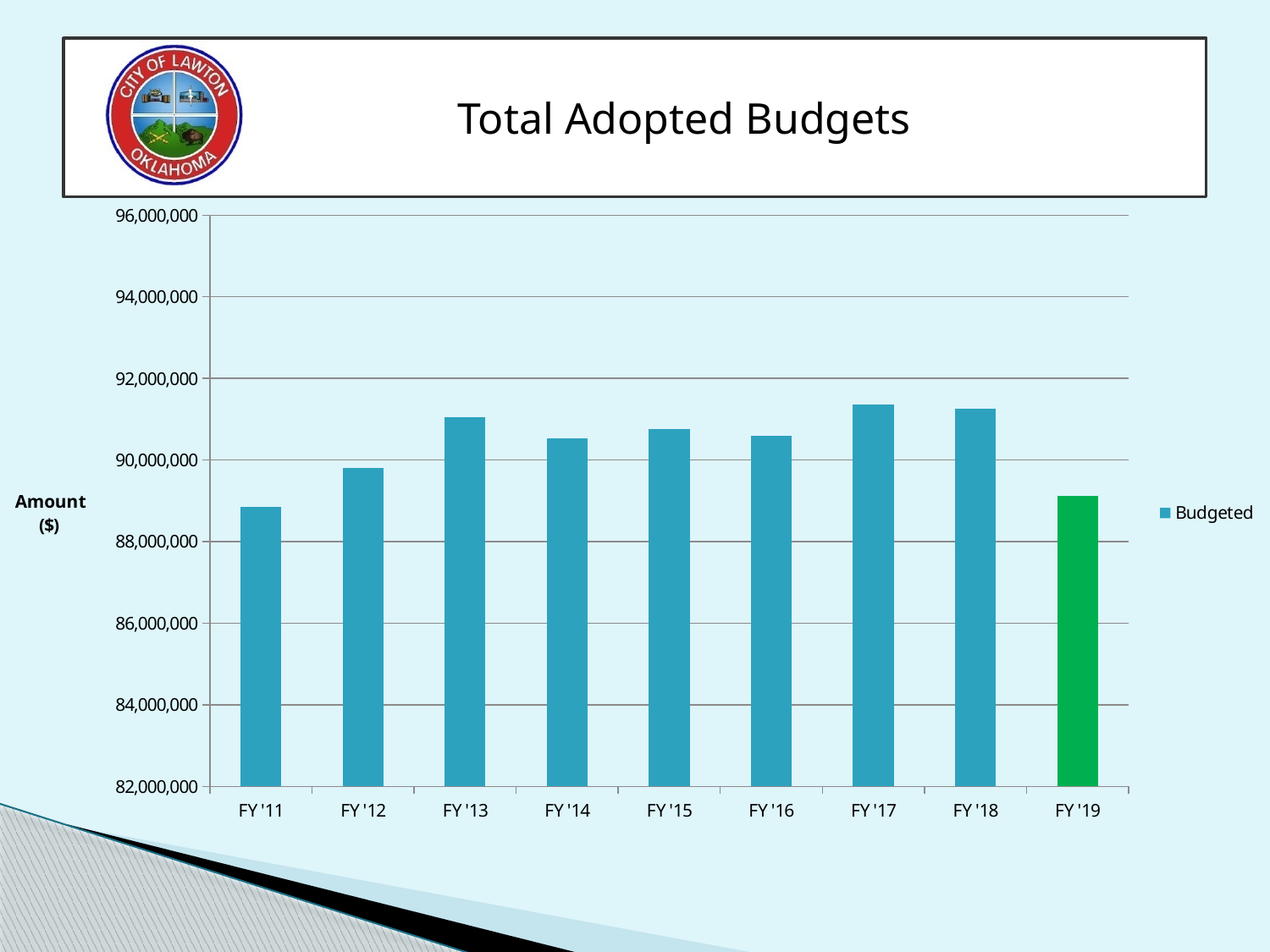
How many series does the legend list? 1 Which fiscal year has the lowest adopted budget? FY '11 Is the value for FY '17 greater or less than 92,000,000? less What is the name of the series shown in the legend? Budgeted Is the value for FY '19 greater or less than 90,000,000? less Is the value for FY '12 greater or less than 88,000,000? greater How many fiscal years are plotted on the chart? 9 What kind of chart is shown on the slide? bar chart Which is larger, the budget for FY '17 or FY '19? FY '17 Which is larger, the budget for FY '13 or FY '12? FY '13